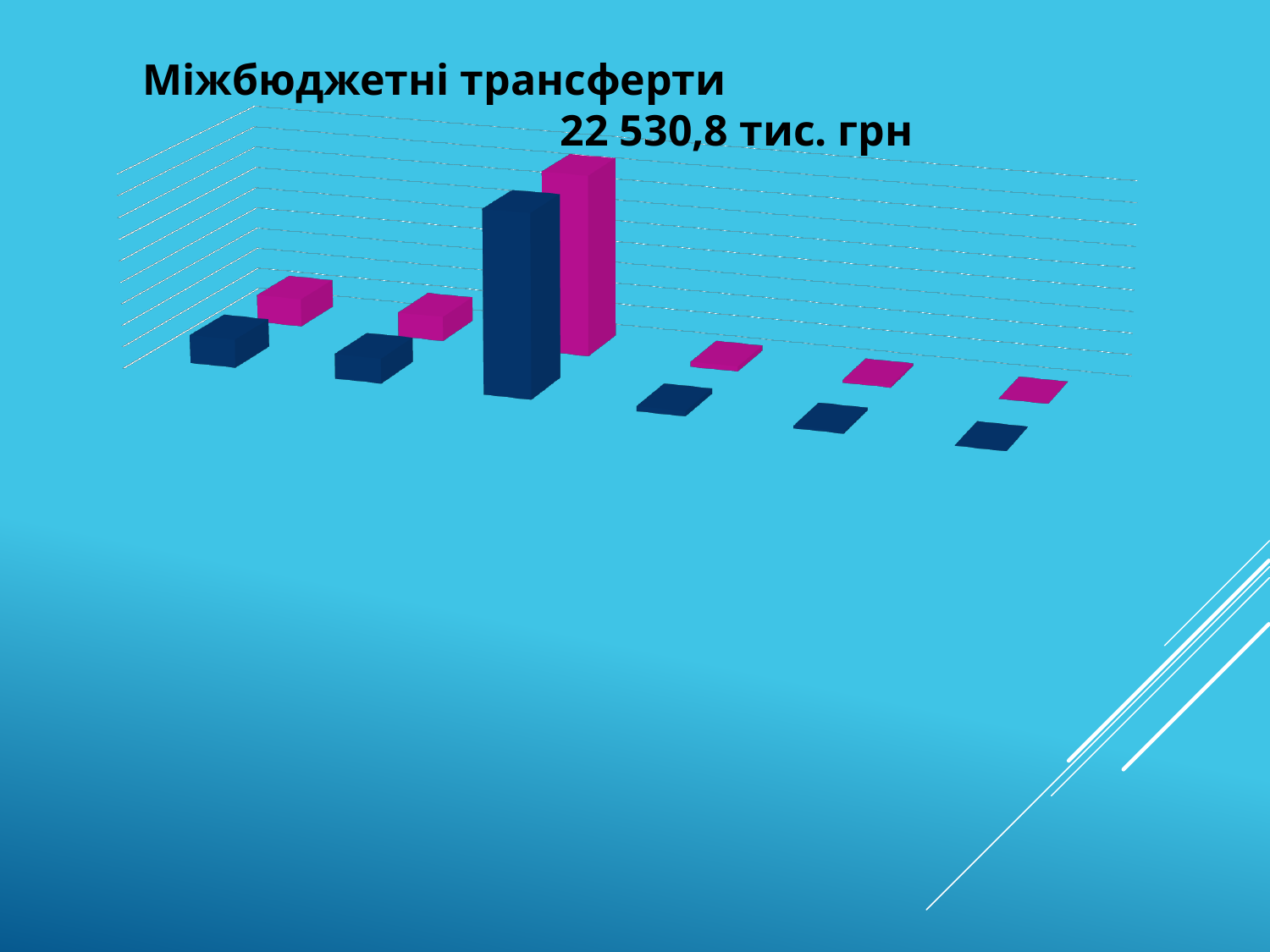
How many bars are there in each group on the chart? 2 Counting from the left, which group of bars is the tallest in the chart? the third What total amount is printed next to the chart title? 22 530,8 тис. грн What kind of chart is shown on the slide? bar chart How many groups of bars are plotted in the chart? 6 What is the title of the chart on the slide? Міжбюджетні трансферти